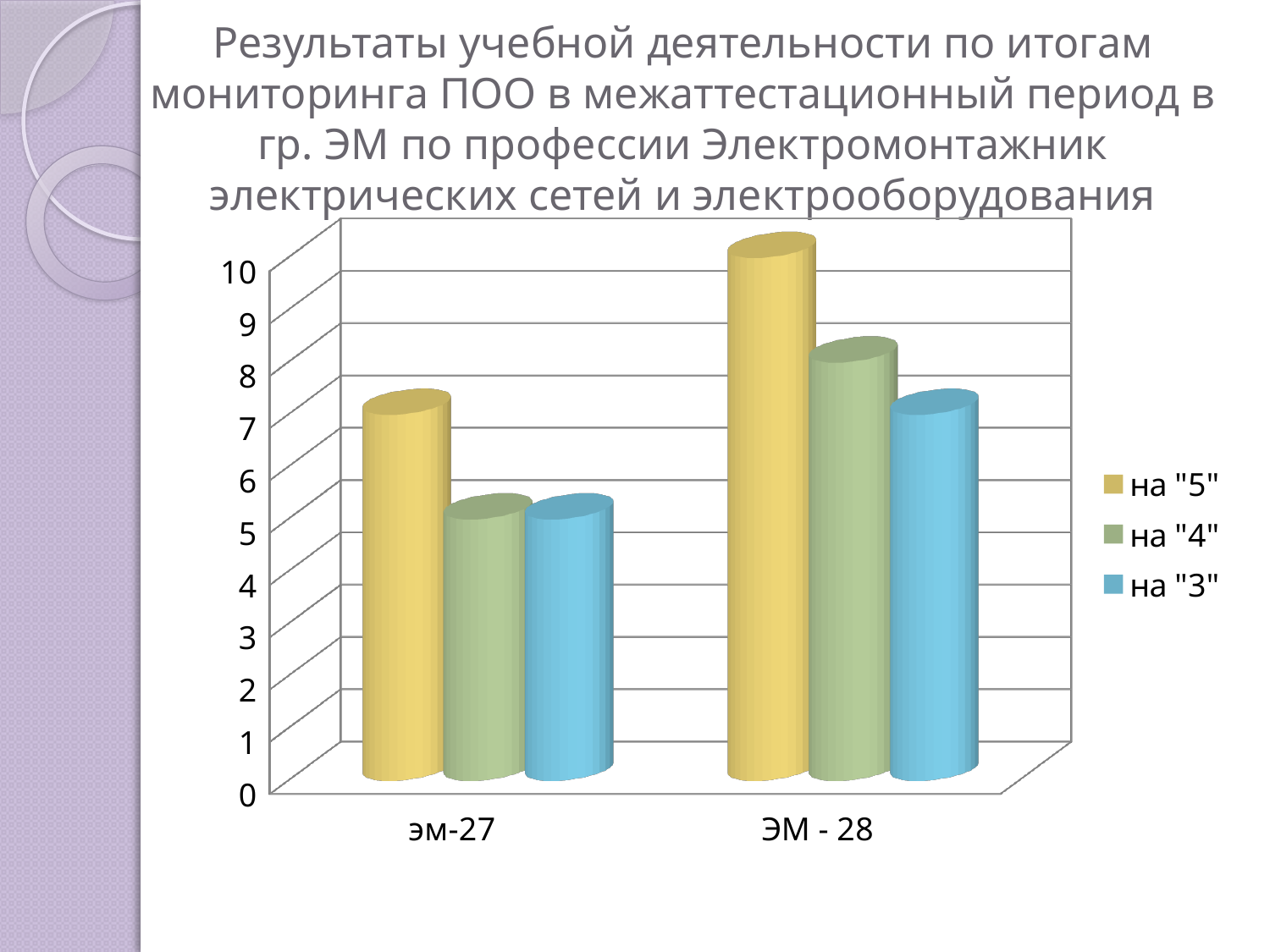
Within the category ЭМ - 28, which series has the lowest value? на "3" Which category has the higher value for the series на "5"? ЭМ - 28 Is the value for на "5" in category эм-27 greater or less than 5? greater What are the three series listed in the chart legend? на "5", на "4", на "3" How many series does the chart legend list? 3 Is the value for на "4" in category эм-27 greater or less than 6? less Which is larger: the value for на "4" in ЭМ - 28 or the value for на "4" in эм-27? ЭМ - 28 Within the category ЭМ - 28, which series has the highest value? на "5" How many categories are shown on the x axis of the chart? 2 What kind of chart is shown on the slide? bar chart Is the value for на "5" in category ЭМ - 28 greater or less than 9? greater Within the category эм-27, which series has the highest value? на "5"